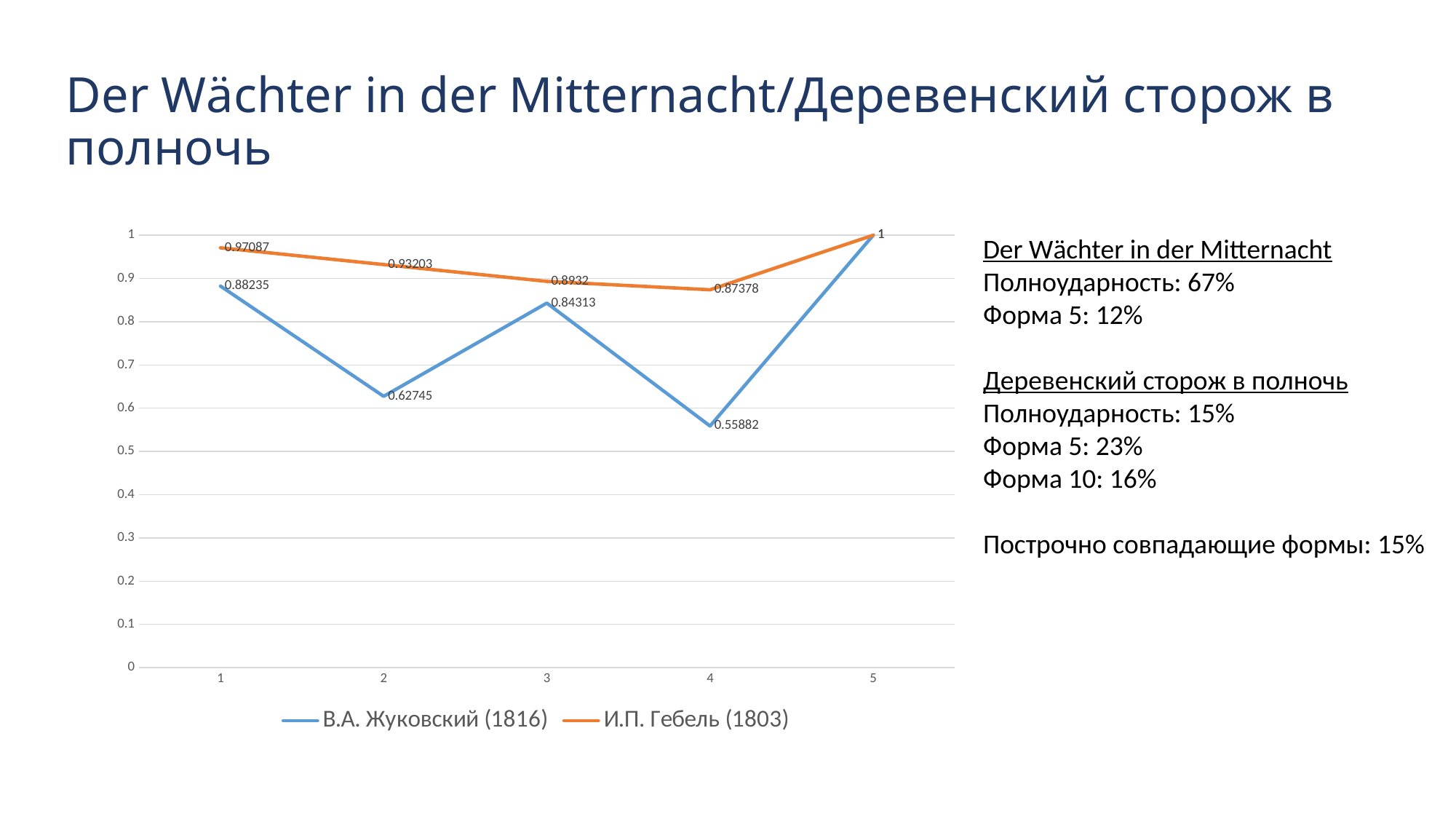
What is the value for И.П. Гебель (1803) at position 3? 0.8932 Does the value for И.П. Гебель (1803) rise or fall from position 1 to position 4? fall How many points are plotted along the x axis for each series? 5 At which position is the value for И.П. Гебель (1803) highest? 5 What is the value for В.А. Жуковский (1816) at position 2? 0.62745 What is the value for В.А. Жуковский (1816) at position 4? 0.55882 How many series does the legend list? 2 What is the difference between the values of И.П. Гебель (1803) and В.А. Жуковский (1816) at position 4? 0.31496 What is the value for И.П. Гебель (1803) at position 1? 0.97087 Which series has the larger value at position 2, В.А. Жуковский (1816) or И.П. Гебель (1803)? И.П. Гебель (1803) What type of chart is shown on the slide? line chart At which position is the value for В.А. Жуковский (1816) lowest? 4